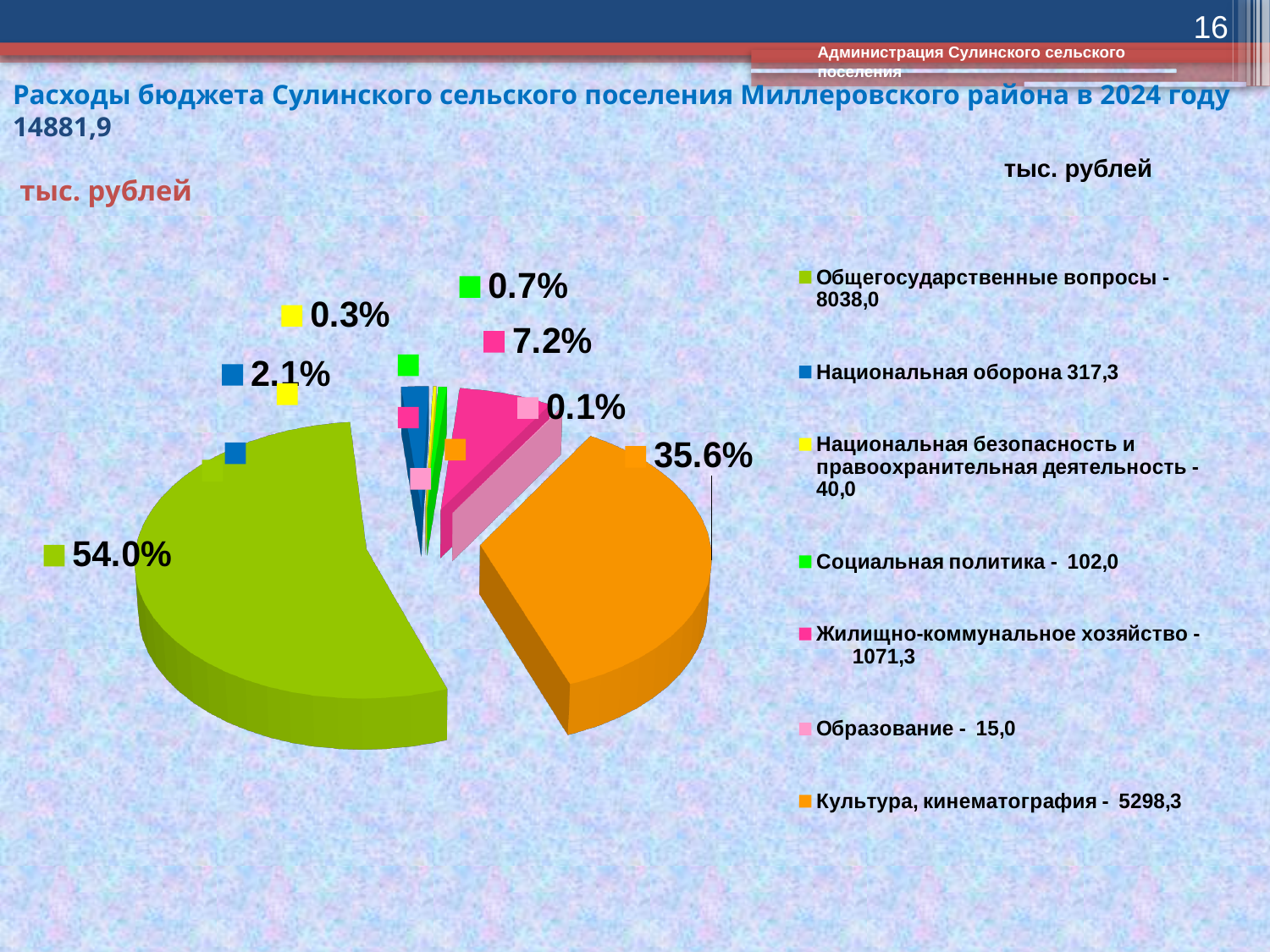
What is the difference in percentage points between the Общегосударственные вопросы slice and the Культура, кинематография slice? 18.4% Which is larger: the slice for Национальная оборона or the slice for Социальная политика? Национальная оборона What value (тыс. рублей) does the legend give for Культура, кинематография? 5298,3 Which category has the smallest slice of the pie? Образование What colour is the slice for Жилищно-коммунальное хозяйство? pink What share of the pie does Общегосударственные вопросы take? 54.0% What share of the pie does Жилищно-коммунальное хозяйство take? 7.2% Which category has the largest slice of the pie? Общегосударственные вопросы How many slices does the pie chart have? 7 What value (тыс. рублей) does the legend give for Национальная оборона? 317,3 What share of the pie does Культура, кинематография take? 35.6% What kind of chart is shown on the slide? pie chart